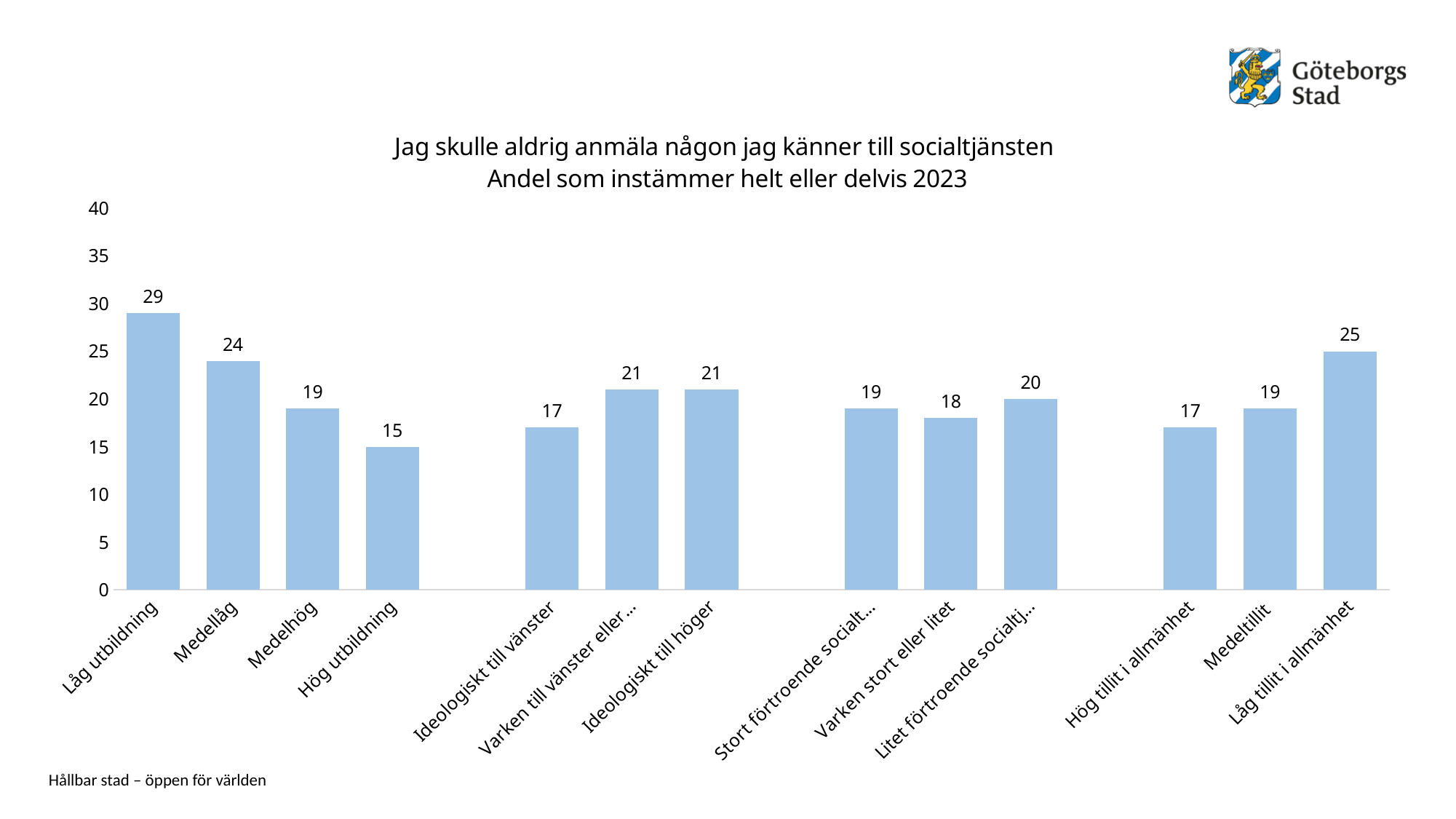
What is the value for Hög utbildning? 15 What is the value for Låg utbildning? 29 What is the difference between the values for Låg utbildning and Hög utbildning? 14 What kind of chart is shown on the slide? Bar chart Which is larger, the value for Medellåg or the value for Medeltillit? Medellåg What is the value for Låg tillit i allmänhet? 25 Do the values rise or fall across the four education categories from Låg utbildning to Hög utbildning? Fall What is the second line of the chart title? Andel som instämmer helt eller delvis 2023 How many bars are shown in the chart? 13 Which category has the highest value? Låg utbildning What is the value for Ideologiskt till höger? 21 Which category has the lowest value? Hög utbildning